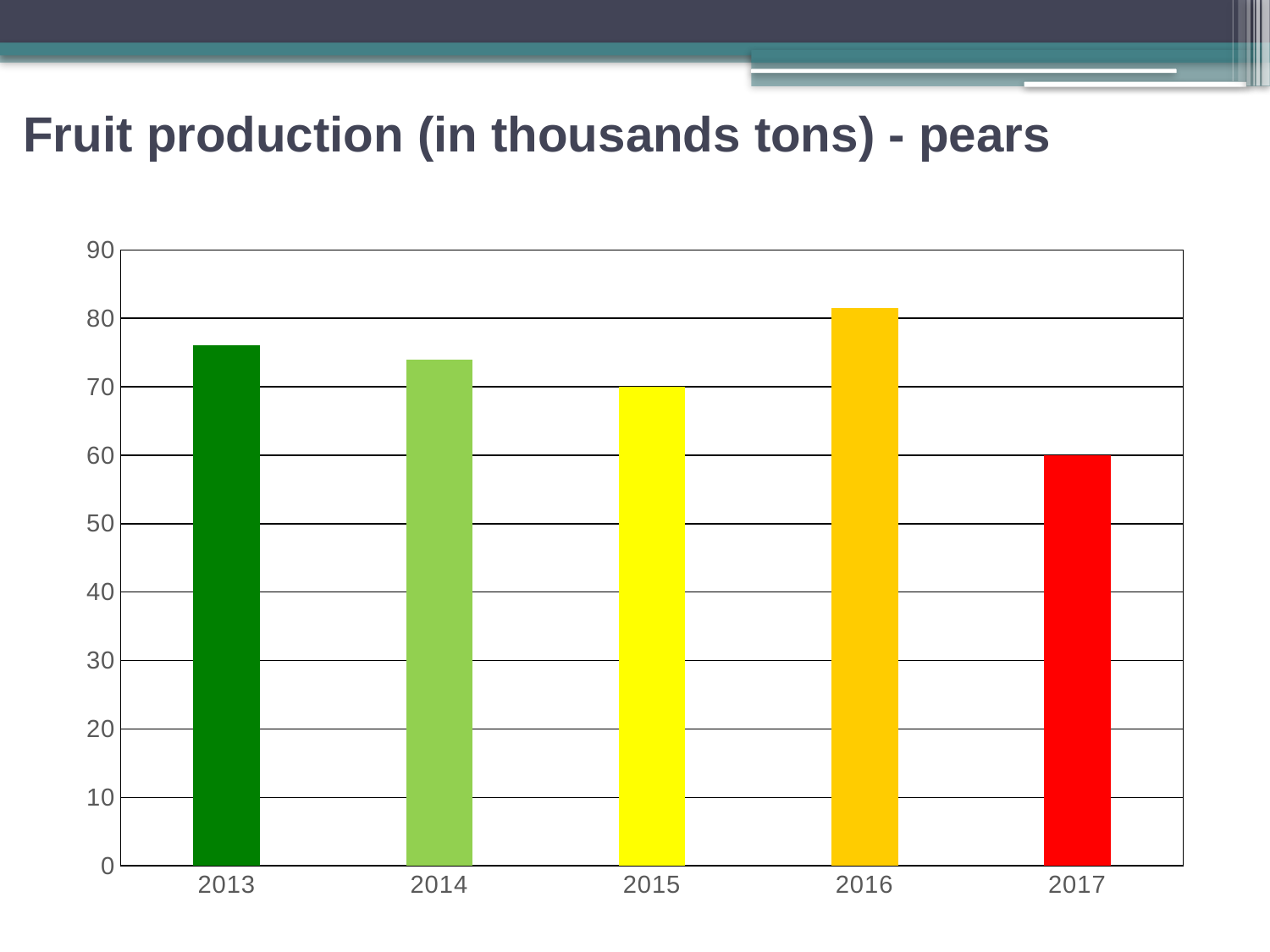
Which year has the lowest pear production? 2017 Which year has the highest pear production? 2016 What is the title of the slide? Fruit production (in thousands tons) - pears How many years are shown on the x axis of the chart? 5 What kind of chart is shown on the slide? Bar chart Is the value for 2013 greater or less than 80? less Which year has the larger pear production, 2016 or 2017? 2016 What is the pear production value for 2015? 70 Is the value for 2016 greater or less than 80? greater Is the value for 2014 greater or less than 70? greater Does pear production rise or fall from 2016 to 2017? Fall What is the pear production value for 2017? 60